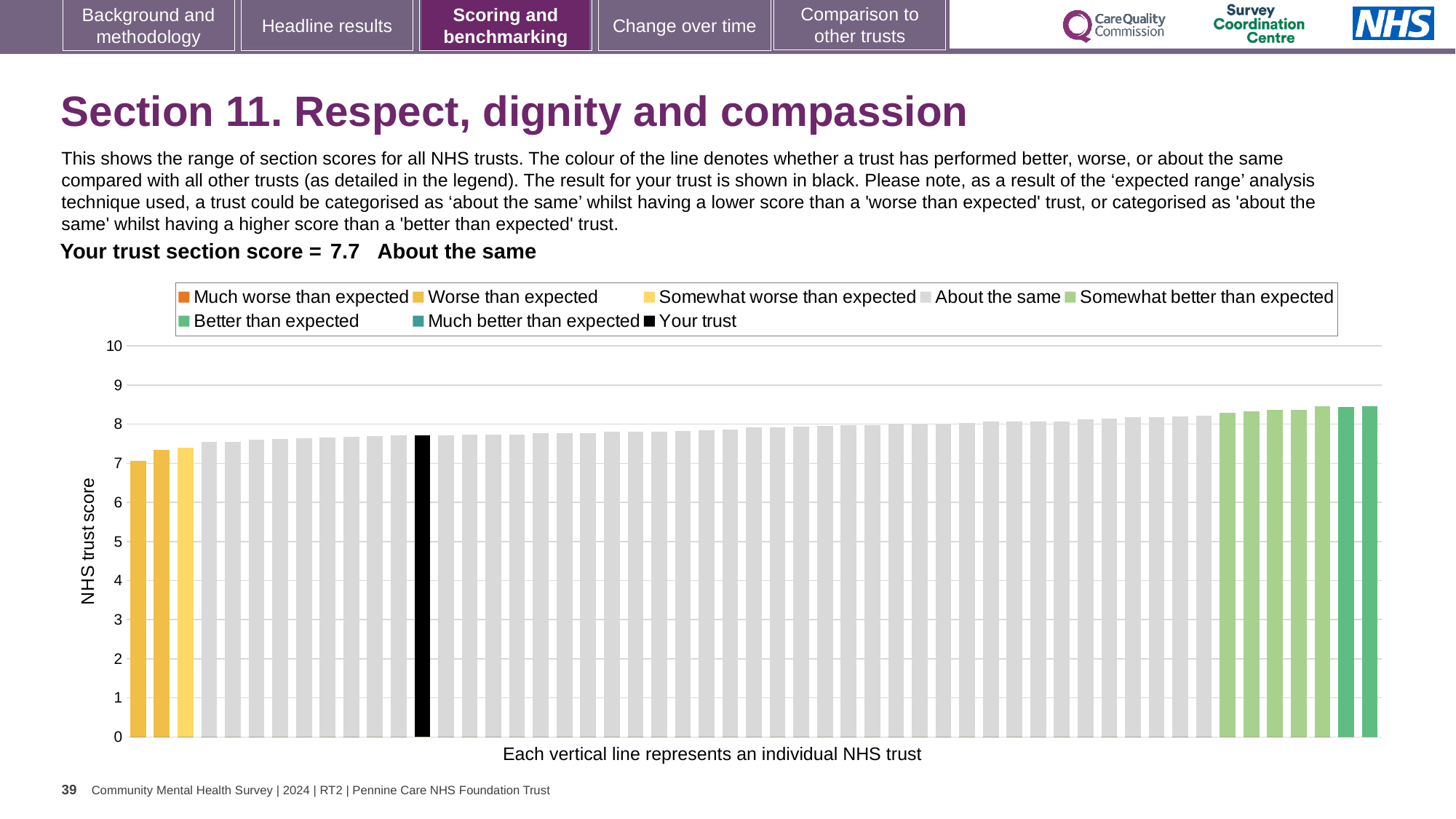
What is the label on the vertical axis of the chart? NHS trust score What kind of chart is shown on the slide? bar chart Do the bar values rise or fall from left to right along the x axis? rise What colour is the bar representing your trust? black Is the value for your trust (the black bar) greater or less than 7? greater Which category is your trust's section score placed in? About the same Is the value of the highest bar in the chart greater or less than 8? greater How many entries does the chart legend list? 8 Is the rightmost bar larger or smaller than the leftmost bar? larger What is the section score for your trust shown on the slide? 7.7 Is the value of the lowest bar in the chart greater or less than 8? less